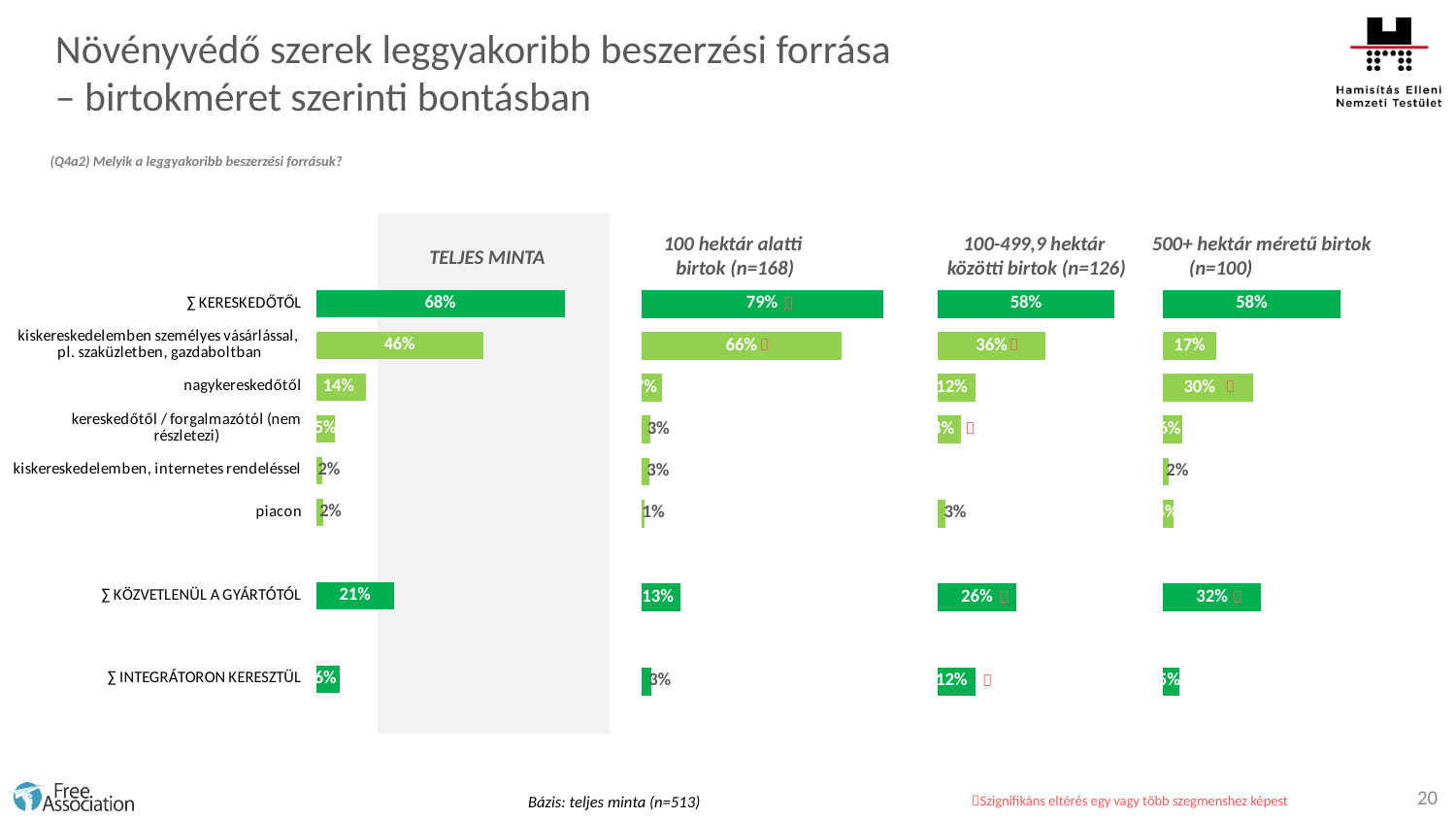
In the TELJES MINTA chart, what is the value for ∑ KERESKEDŐTŐL? 68% In the 500+ hektár méretű birtok (n=100) chart, what is the value for nagykereskedőtől? 30% Which is larger for kiskereskedelemben személyes vásárlással: the 100 hektár alatti birtok (n=168) chart or the 500+ hektár méretű birtok (n=100) chart? 100 hektár alatti birtok (n=168) In the TELJES MINTA chart, which category has the highest value? ∑ KERESKEDŐTŐL In the 100-499,9 hektár közötti birtok (n=126) chart, what is the value for ∑ KÖZVETLENÜL A GYÁRTÓTÓL? 26% In the 100 hektár alatti birtok (n=168) chart, what is the value for kiskereskedelemben személyes vásárlással, pl. szaküzletben, gazdaboltban? 66% What kind of chart is used on this slide? Bar chart In the TELJES MINTA chart, what is the value for ∑ KÖZVETLENÜL A GYÁRTÓTÓL? 21% In the 500+ hektár méretű birtok (n=100) chart, what is the difference between ∑ KERESKEDŐTŐL and ∑ KÖZVETLENÜL A GYÁRTÓTÓL? 26% In the 100 hektár alatti birtok (n=168) chart, what is the value for ∑ KERESKEDŐTŐL? 79% What is the sample size (n) shown for the 100-499,9 hektár közötti birtok chart? 126 In the TELJES MINTA chart, what is the difference between ∑ KERESKEDŐTŐL and kiskereskedelemben személyes vásárlással, pl. szaküzletben, gazdaboltban? 22%